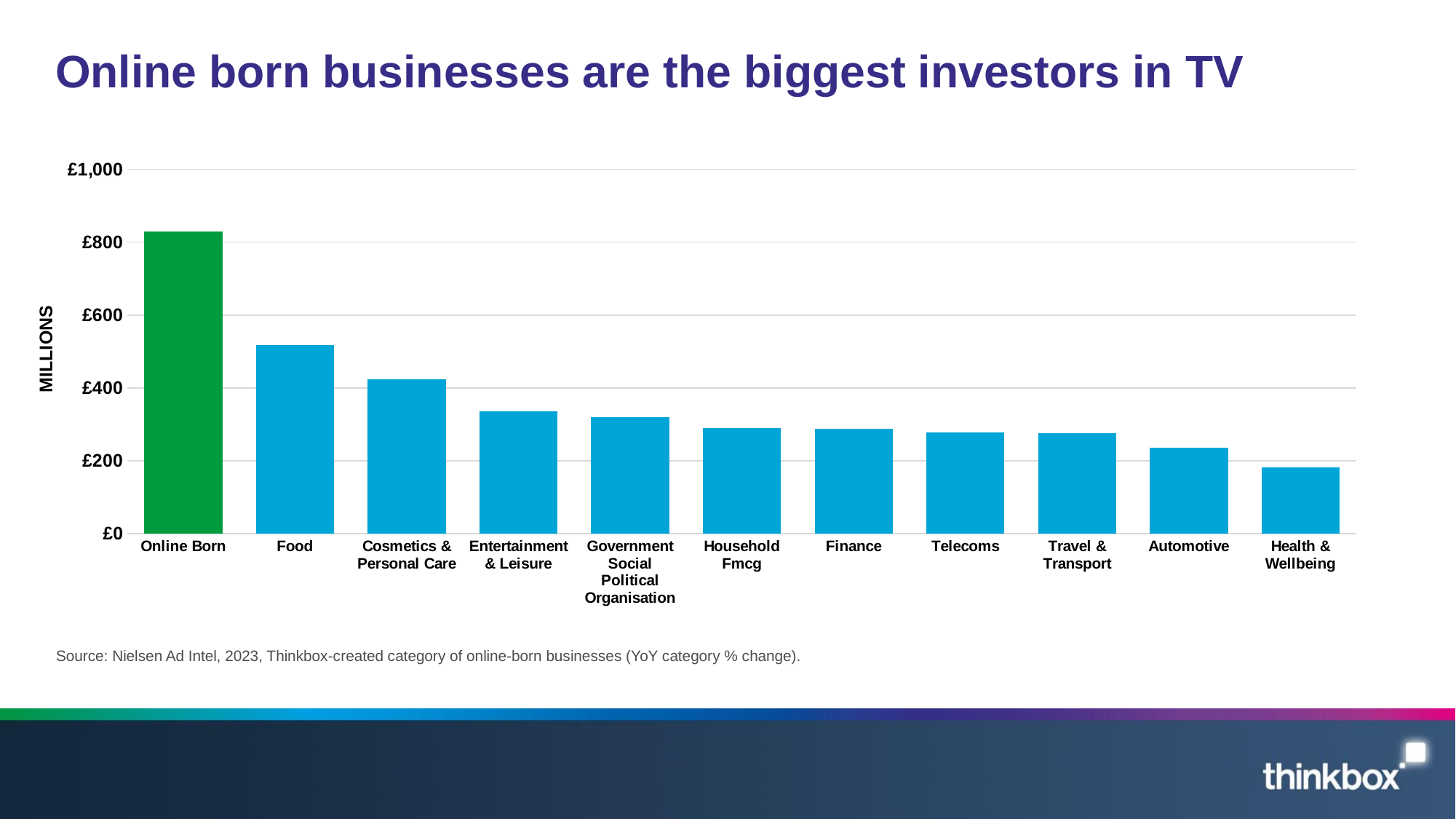
Is the value for Health & Wellbeing greater or less than £200? less What kind of chart is shown on the slide? Bar chart Which bar in the chart is coloured green rather than blue? Online Born Is the value for Online Born greater or less than £800? greater Do the values rise or fall moving from left to right along the x axis? Fall Which is larger, the value for Food or the value for Cosmetics & Personal Care? Food Which category has the lowest value in the chart? Health & Wellbeing Is the value for Food greater or less than £600? less How many categories are shown on the x axis of the chart? 11 Which category has the highest value in the chart? Online Born